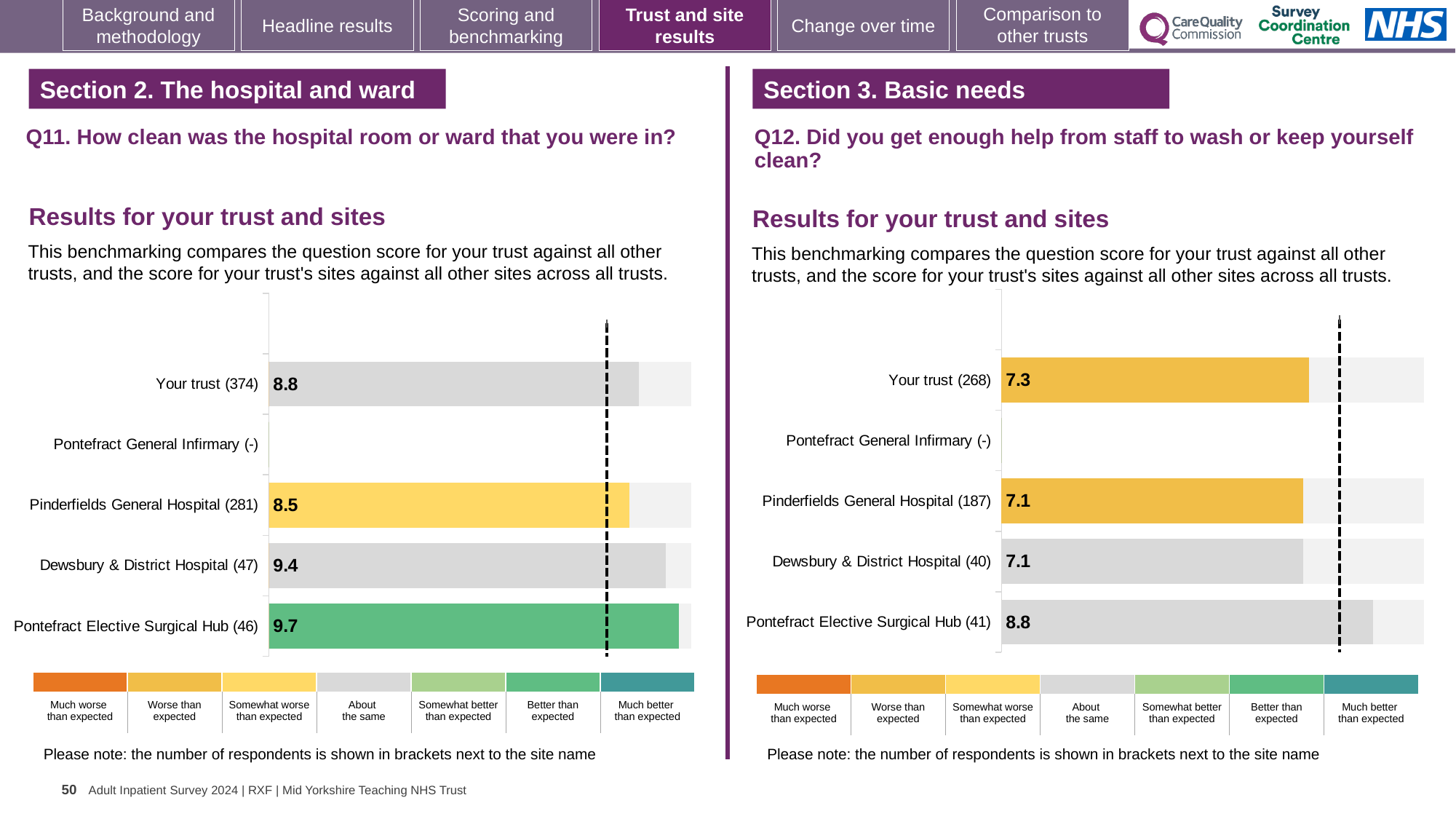
In the Q11 chart on the left, what is the score for Your trust? 8.8 In the Q12 chart on the right, which site has the highest score? Pontefract Elective Surgical Hub In the Q12 chart on the right, what is the score for Your trust? 7.3 In the Q12 chart on the right, is the score for Your trust larger or smaller than the score for Pinderfields General Hospital? larger In the Q11 chart on the left, which site with a plotted score has the lowest score? Pinderfields General Hospital In the Q12 chart on the right, what is the score for Pontefract Elective Surgical Hub? 8.8 How many sites (rows) are listed in the Q11 chart on the left? 5 In the Q11 chart on the left, which site has the highest score? Pontefract Elective Surgical Hub In the Q11 chart on the left, what is the score for Dewsbury & District Hospital? 9.4 In the Q11 chart on the left, what is the difference between the scores for Pontefract Elective Surgical Hub and Pinderfields General Hospital? 1.2 In the Q12 chart on the right, what is the difference between the scores for Pontefract Elective Surgical Hub and Your trust? 1.5 What kind of chart is used for the Q12 results on the right? bar chart